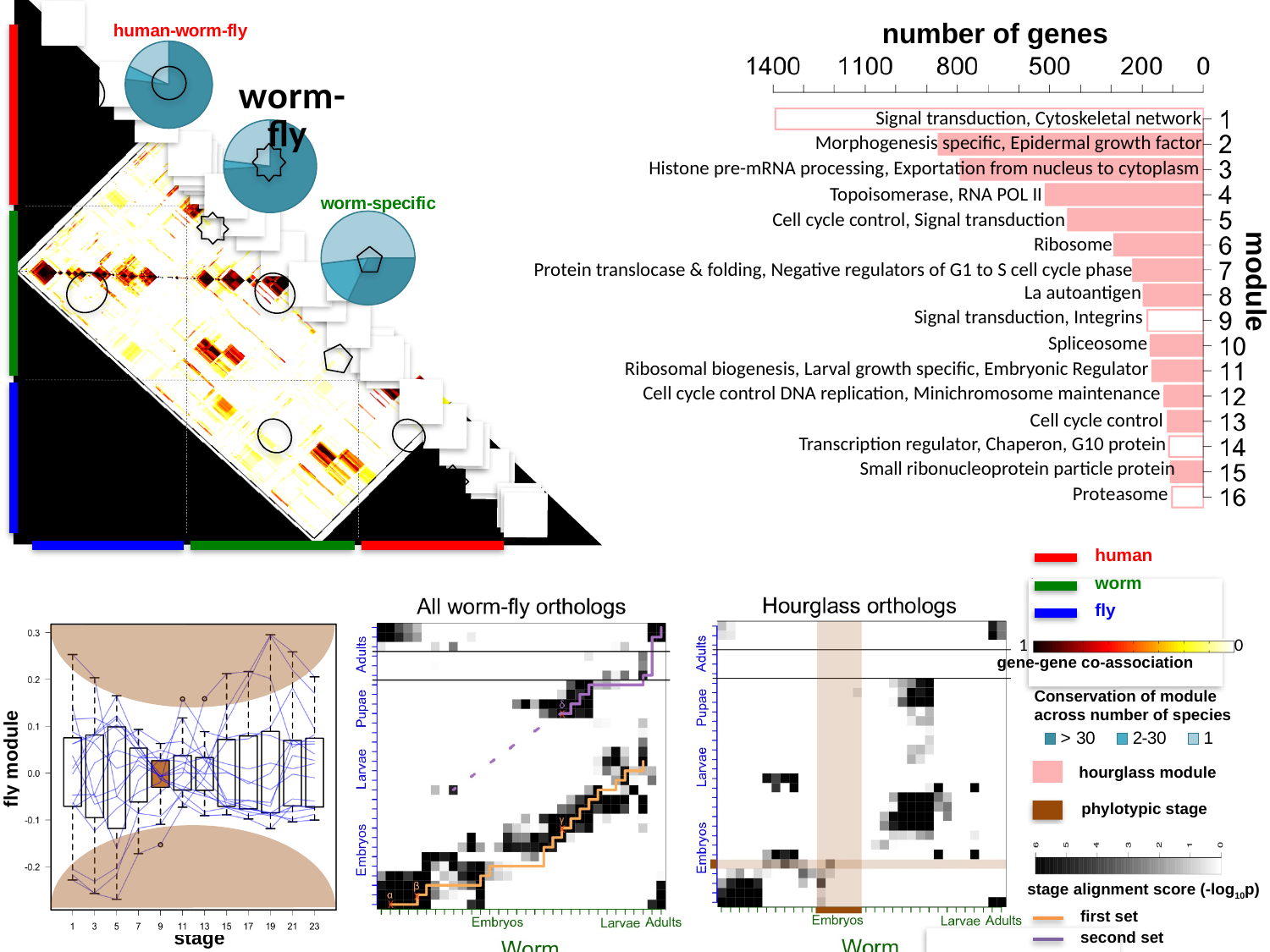
What is the x-axis label of the box plot in the bottom left? stage What is the label on the vertical axis of the 'number of genes' chart? module In the 'number of genes' chart, is the value for module 3 (Histone pre-mRNA processing, Exportation from nucleus to cytoplasm) greater or less than 1100? less In the 'number of genes' chart, which module has the largest number of genes? Module 1 (Signal transduction, Cytoskeletal network) In the 'number of genes' chart, is the value for module 4 (Topoisomerase, RNA POL II) greater or less than 800? less In the 'number of genes' chart, which has more genes: module 2 (Morphogenesis specific, Epidermal growth factor) or module 4 (Topoisomerase, RNA POL II)? Module 2 In the 'number of genes' chart, do the bar lengths increase or decrease as the module number goes from 1 to 16? decrease In the 'number of genes' chart, is the value for module 16 (Proteasome) greater or less than 200? less In the 'number of genes' chart, how many modules are plotted? 16 What kind of chart is the 'number of genes' chart in the top right? bar chart